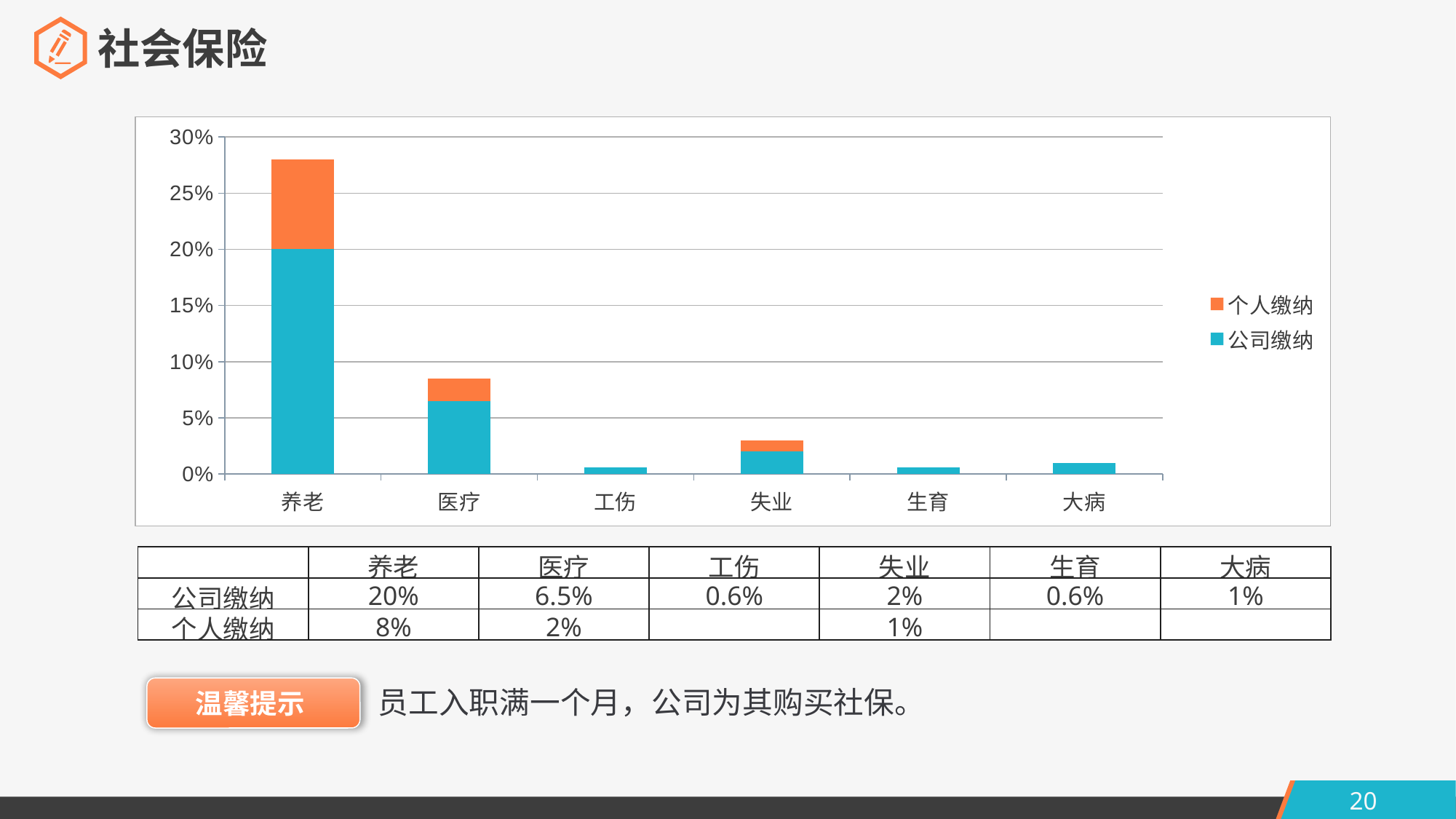
What is the total height of the stacked bar for 养老? 28% What is the difference between the 公司缴纳 values for 养老 and 医疗? 13.5% What is the 个人缴纳 value for 失业? 1% What is the 公司缴纳 value for 养老? 20% How many series does the legend list? 2 How many categories are shown on the x axis? 6 What is the total height of the stacked bar for 医疗? 8.5% Which category has the highest 公司缴纳 value? 养老 Which colour represents 个人缴纳 in the legend? orange What type of chart is shown on the slide? stacked bar chart What is the 个人缴纳 value for 医疗? 2% What is the 公司缴纳 value for 工伤? 0.6%